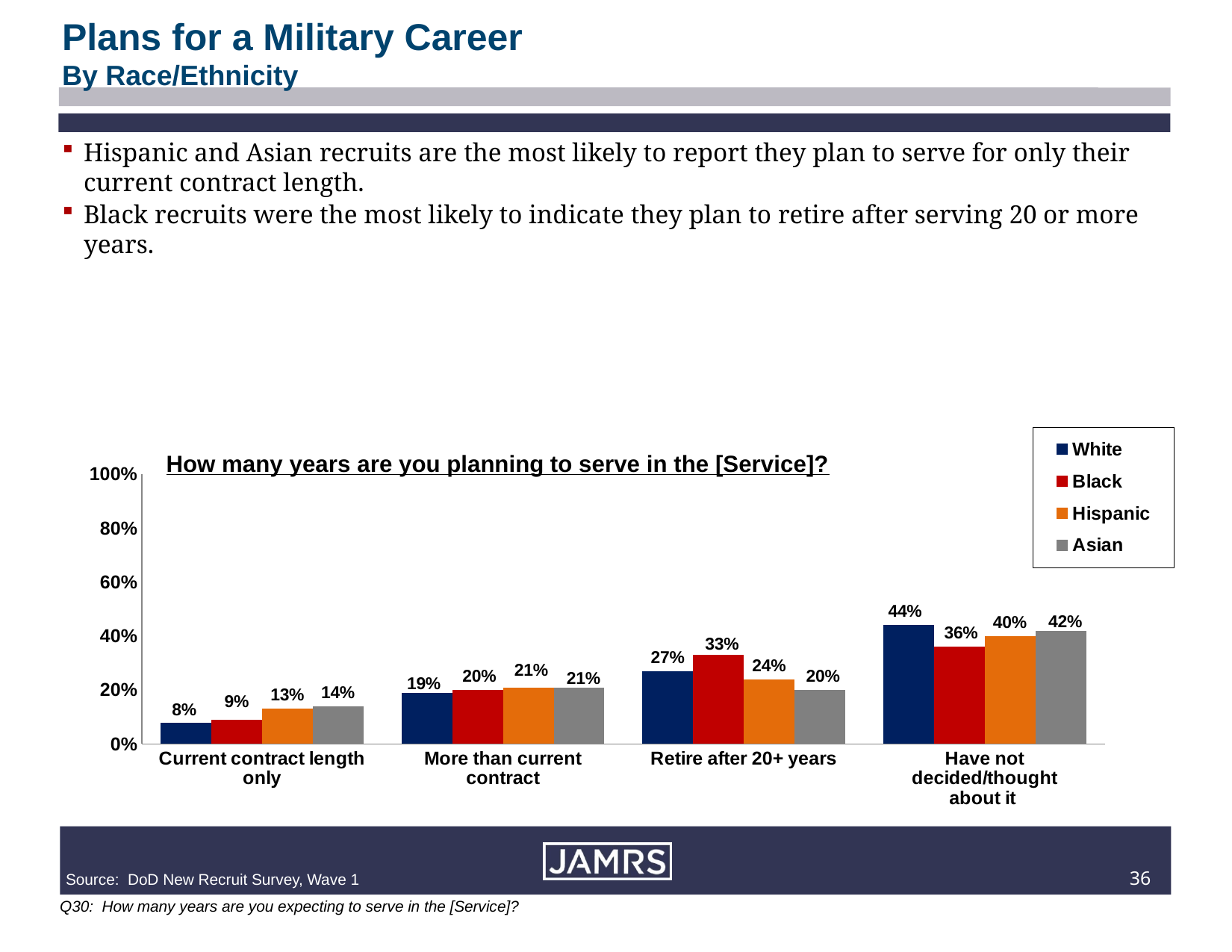
What is the title of the chart? How many years are you planning to serve in the [Service]? What is the value for Asian recruits in the 'Current contract length only' category? 14% Is the value for White recruits in 'Have not decided/thought about it' greater or less than 40%? greater Which race/ethnicity group has the lowest value for 'Current contract length only'? White Which is larger: the Hispanic value for 'Have not decided/thought about it' or the Black value for the same category? Hispanic How many response categories are shown on the x axis? 4 Which race/ethnicity group has the highest value for 'Have not decided/thought about it'? White What percentage of Black recruits plan to retire after 20+ years? 33% What kind of chart is shown on the slide? Bar chart What percentage of White recruits have not decided/thought about it? 44% What is the difference between the Black and Asian values for 'Retire after 20+ years'? 13% How many series does the legend list? 4